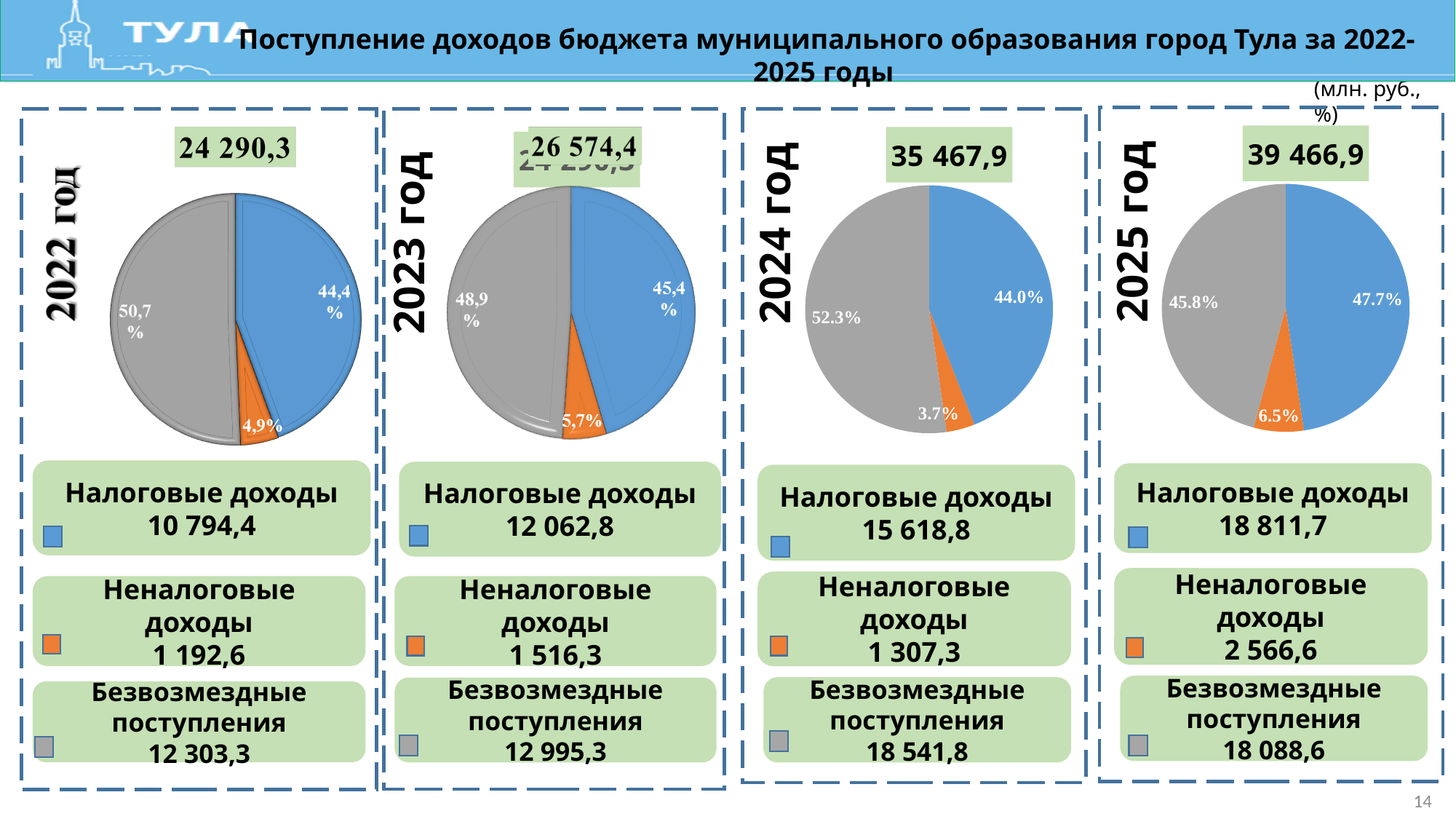
In the 2025 год chart, which is larger: Налоговые доходы or Безвозмездные поступления? Налоговые доходы How many categories does each pie chart on the slide show? 3 In the 2025 год chart, what is the value for Неналоговые доходы? 2 566,6 In the 2023 год pie chart, which category is the smallest? Неналоговые доходы What type of chart is used for each year on the slide? Pie chart In the 2023 год pie chart, what share of the pie is Безвозмездные поступления? 48,9% In the 2024 год chart, what is the value for Налоговые доходы? 15 618,8 In the 2022 год pie chart, which category is the largest? Безвозмездные поступления In the 2024 год pie chart, what share of the pie is Неналоговые доходы? 3.7% In the 2022 год pie chart, what share of the pie is Налоговые доходы? 44,4% In the 2024 год chart, what is the difference between Безвозмездные поступления and Налоговые доходы? 2 923,0